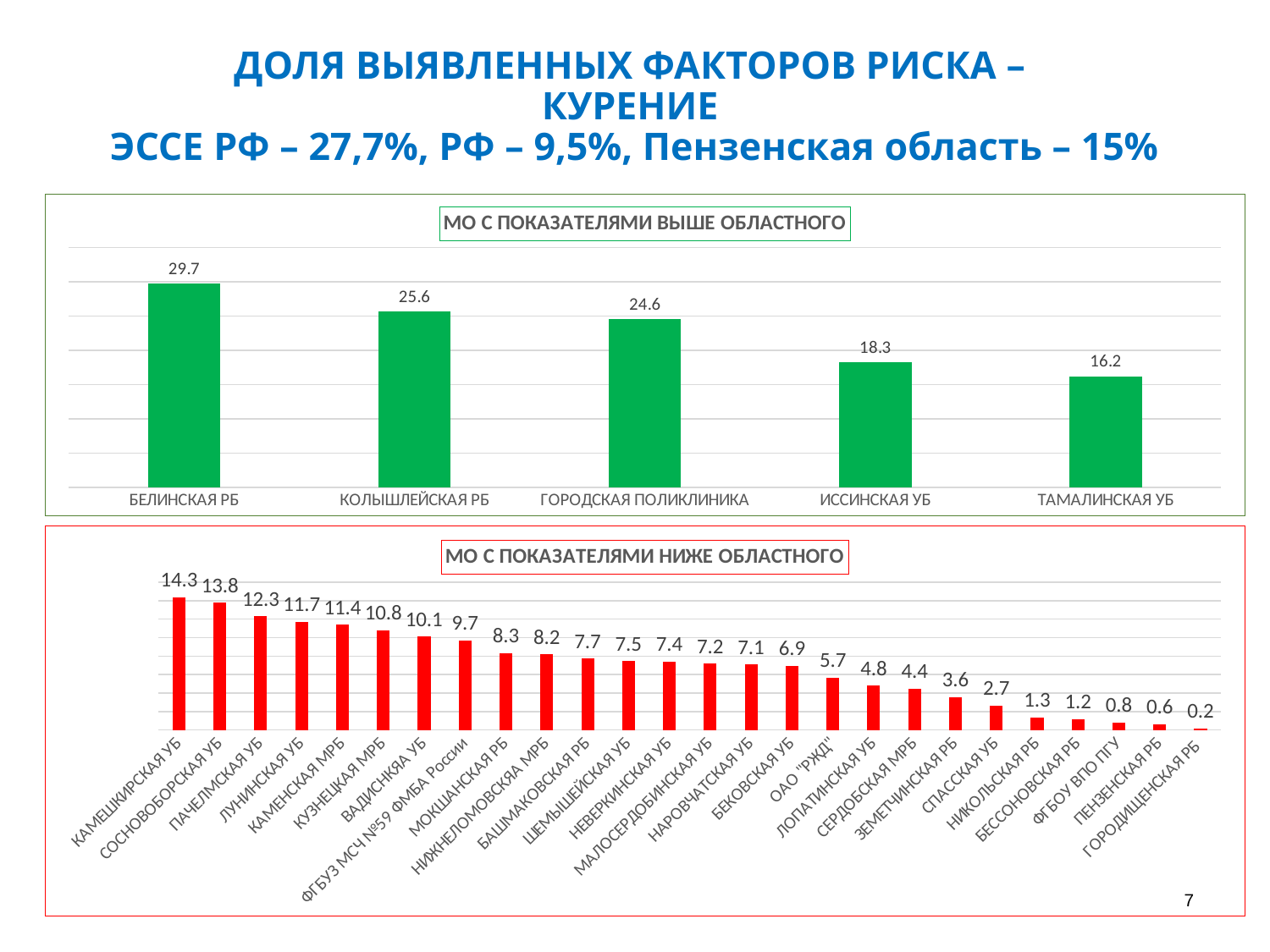
In the top chart (МО С ПОКАЗАТЕЛЯМИ ВЫШЕ ОБЛАСТНОГО), what is the value for БЕЛИНСКАЯ РБ? 29.7 In the bottom chart (МО С ПОКАЗАТЕЛЯМИ НИЖЕ ОБЛАСТНОГО), what is the value for КУЗНЕЦКАЯ МРБ? 10.8 What type of chart is the bottom chart (МО С ПОКАЗАТЕЛЯМИ НИЖЕ ОБЛАСТНОГО)? bar chart In the bottom chart (МО С ПОКАЗАТЕЛЯМИ НИЖЕ ОБЛАСТНОГО), what is the value for ОАО "РЖД"? 5.7 In the bottom chart (МО С ПОКАЗАТЕЛЯМИ НИЖЕ ОБЛАСТНОГО), which is larger: ЛОПАТИНСКАЯ УБ or ЗЕМЕТЧИНСКАЯ РБ? ЛОПАТИНСКАЯ УБ In the top chart (МО С ПОКАЗАТЕЛЯМИ ВЫШЕ ОБЛАСТНОГО), what is the value for ИССИНСКАЯ УБ? 18.3 In the top chart (МО С ПОКАЗАТЕЛЯМИ ВЫШЕ ОБЛАСТНОГО), what is the difference between КОЛЫШЛЕЙСКАЯ РБ and ГОРОДСКАЯ ПОЛИКЛИНИКА? 1.0 In the bottom chart (МО С ПОКАЗАТЕЛЯМИ НИЖЕ ОБЛАСТНОГО), which category has the lowest value? ГОРОДИЩЕНСКАЯ РБ In the top chart (МО С ПОКАЗАТЕЛЯМИ ВЫШЕ ОБЛАСТНОГО), do the values rise or fall from left to right? fall In the bottom chart (МО С ПОКАЗАТЕЛЯМИ НИЖЕ ОБЛАСТНОГО), which category has the highest value? КАМЕШКИРСКАЯ УБ In the top chart (МО С ПОКАЗАТЕЛЯМИ ВЫШЕ ОБЛАСТНОГО), which category has the lowest value? ТАМАЛИНСКАЯ УБ In the top chart (МО С ПОКАЗАТЕЛЯМИ ВЫШЕ ОБЛАСТНОГО), how many categories are shown? 5